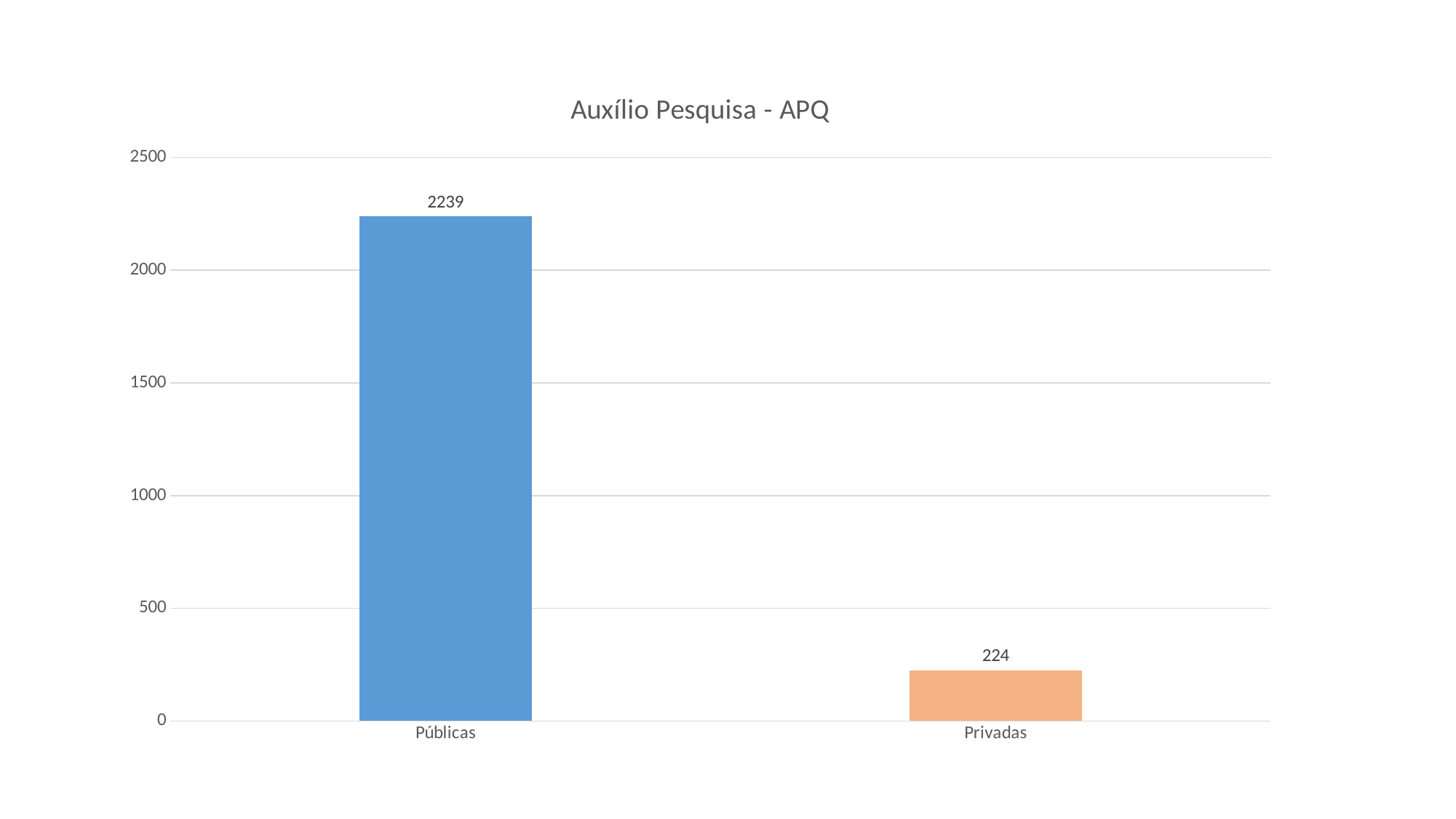
What colour is the bar for Privadas? orange What kind of chart is shown on the slide? bar chart What is the difference between the values for Públicas and Privadas? 2015 What is the title of the chart? Auxílio Pesquisa - APQ Which is larger, the value for Públicas or the value for Privadas? Públicas Is the value for Públicas greater or less than 2000? greater Is the value for Privadas greater or less than 500? less What is the value for Privadas? 224 How many categories are shown in the chart? 2 Which category has the highest value? Públicas Which category has the lowest value? Privadas What is the value for Públicas? 2239